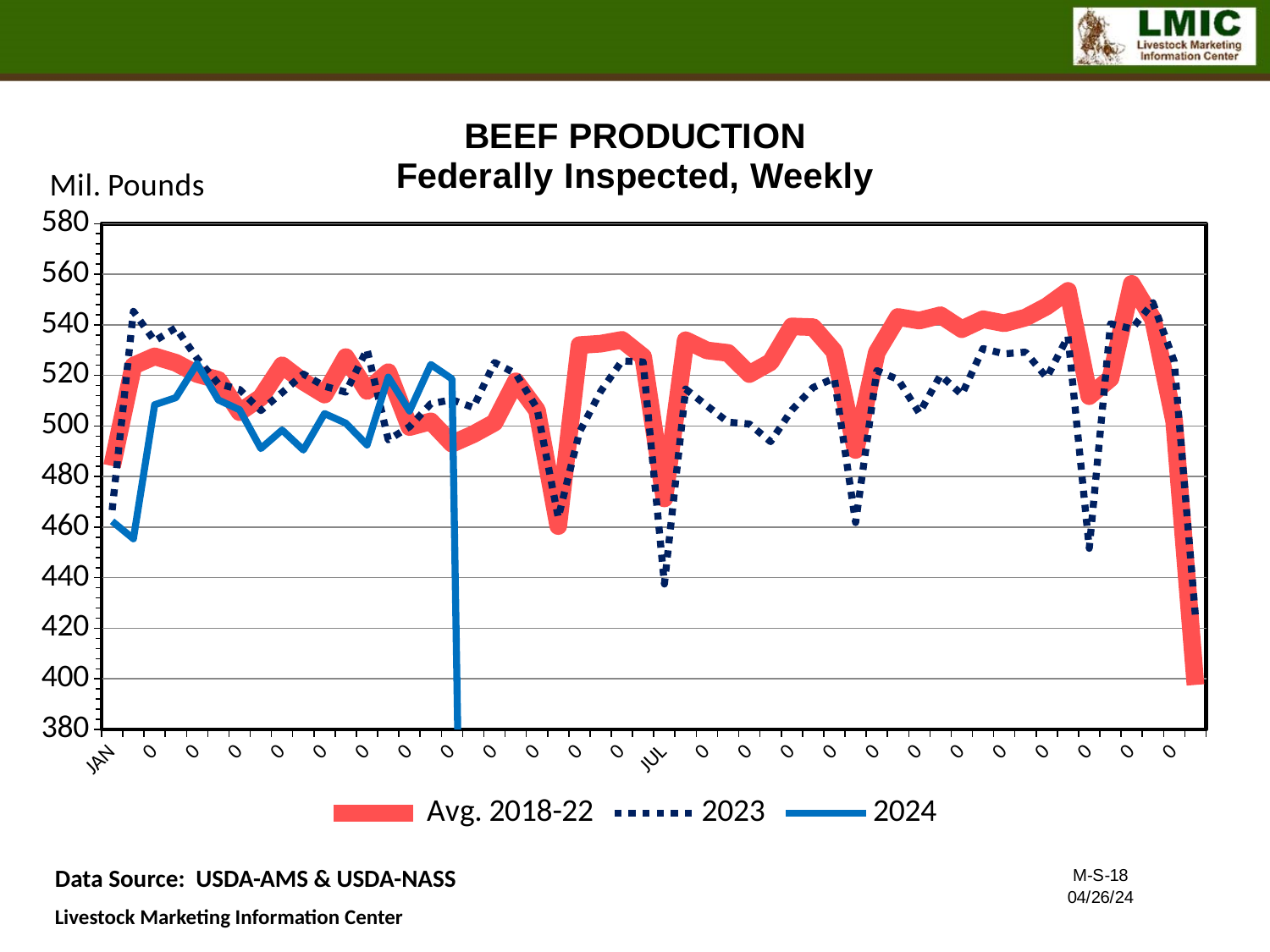
Over the final weeks of the year, does the Avg. 2018-22 line rise or fall? fall Is the value of the Avg. 2018-22 line at JAN greater or less than 500? less Is the value of the 2024 line at JAN greater or less than 480? less Near JUL, which line dips lower: 2023 or Avg. 2018-22? 2023 Is the lowest point of the 2023 line, near JUL, greater or less than 460? less How many series does the legend list? 3 At JAN, which is higher: the Avg. 2018-22 line or the 2023 line? Avg. 2018-22 What kind of chart is shown on the slide? Line chart What unit is shown on the y axis of the chart? Mil. Pounds What are the three series listed in the legend? Avg. 2018-22, 2023, 2024